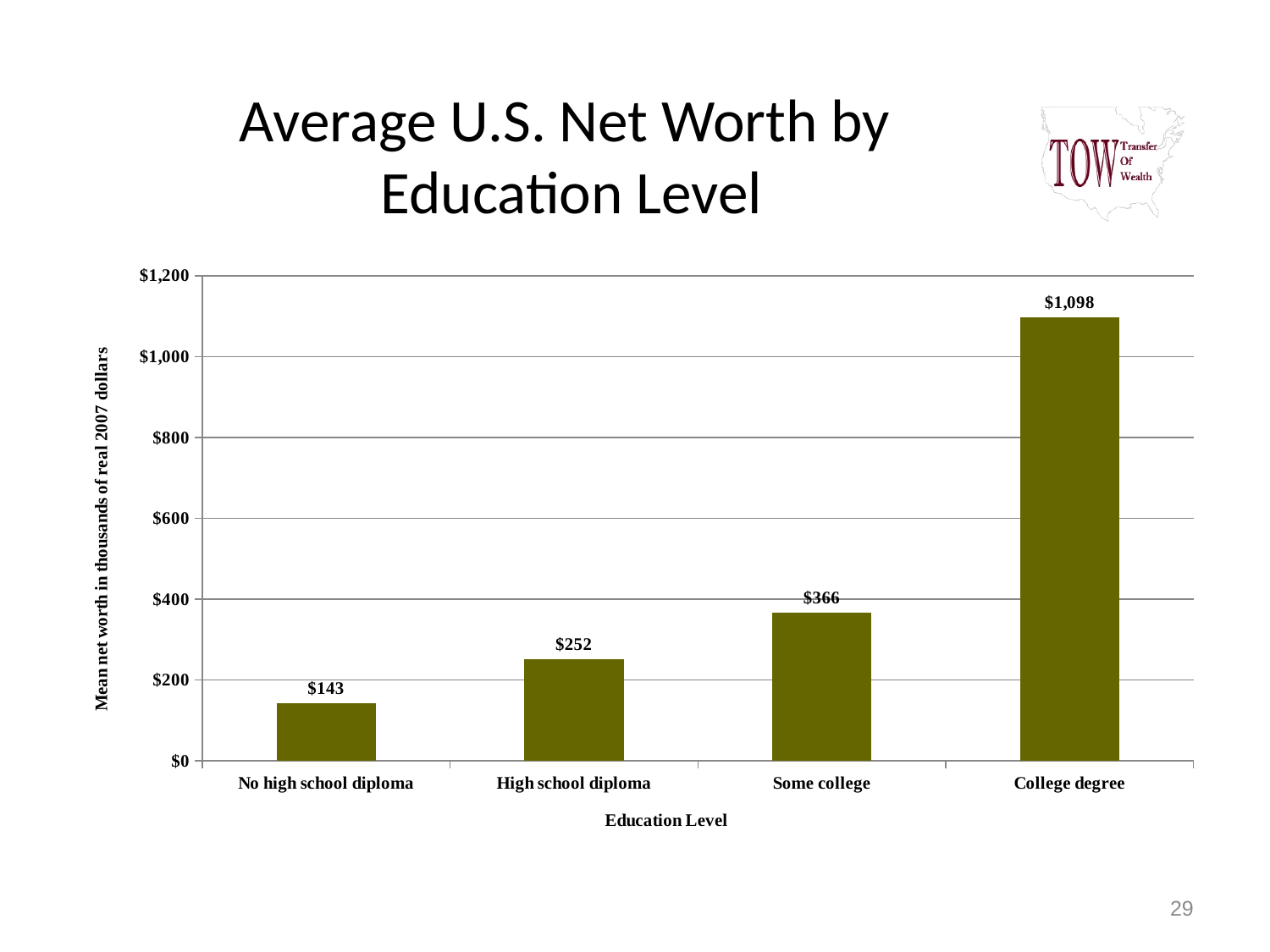
What is the difference between the values for 'College degree' and 'Some college'? $732 Which education level has the lowest mean net worth? No high school diploma What is the mean net worth for the 'No high school diploma' category? $143 Is the value for 'College degree' greater or less than $1,000? greater What kind of chart is shown on the slide? Bar chart Which is larger, the value for 'High school diploma' or the value for 'Some college'? Some college What is the mean net worth for the 'College degree' category? $1,098 Do the values rise or fall moving from left to right along the x axis? Rise What is the value shown for 'Some college'? $366 Which education level has the highest mean net worth? College degree What is the difference between the values for 'High school diploma' and 'No high school diploma'? $109 How many education level categories are shown in the chart? 4